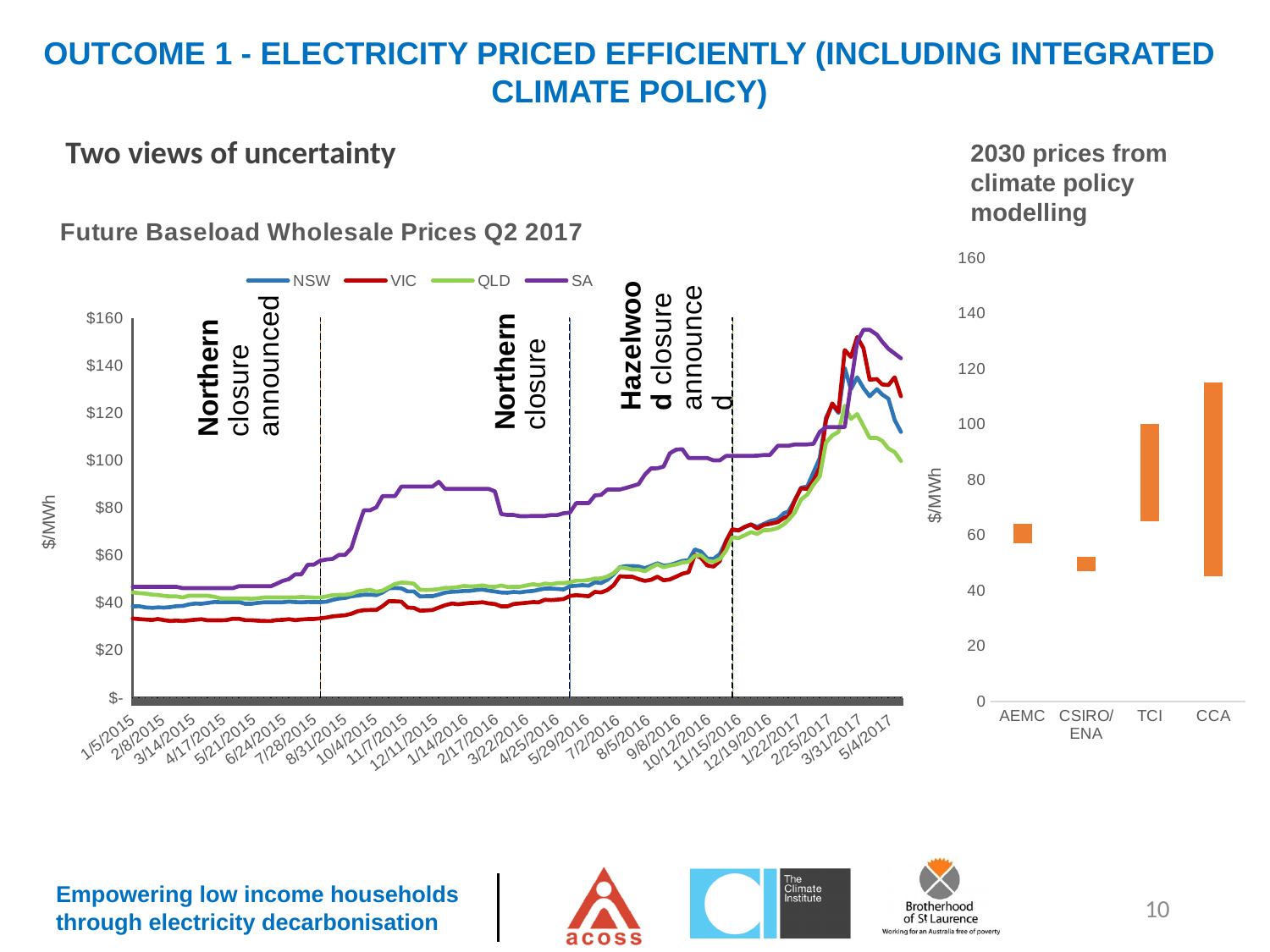
What kind of chart is the '2030 prices from climate policy modelling' chart? bar chart What is the y-axis label of the 'Future Baseload Wholesale Prices Q2 2017' chart? $/MWh In the 'Future Baseload Wholesale Prices Q2 2017' chart, is the VIC value at 1/5/2015 greater or less than $40? less How many categories are shown on the x axis of the '2030 prices from climate policy modelling' chart? 4 In the '2030 prices from climate policy modelling' chart, which category has the widest price range? CCA In the '2030 prices from climate policy modelling' chart, is the top of the TCI bar greater or less than 80? greater How many series does the legend of the 'Future Baseload Wholesale Prices Q2 2017' chart list? 4 In the 'Future Baseload Wholesale Prices Q2 2017' chart, which series has the highest value at the end of the period (5/4/2017)? SA In the 'Future Baseload Wholesale Prices Q2 2017' chart, which series has the lowest value at the start of the period (1/5/2015)? VIC In the 'Future Baseload Wholesale Prices Q2 2017' chart, is the SA value at 3/31/2017 greater or less than $140? greater What kind of chart is the 'Future Baseload Wholesale Prices Q2 2017' chart? line chart In the 'Future Baseload Wholesale Prices Q2 2017' chart, do prices generally rise or fall from 2015 to 2017? rise